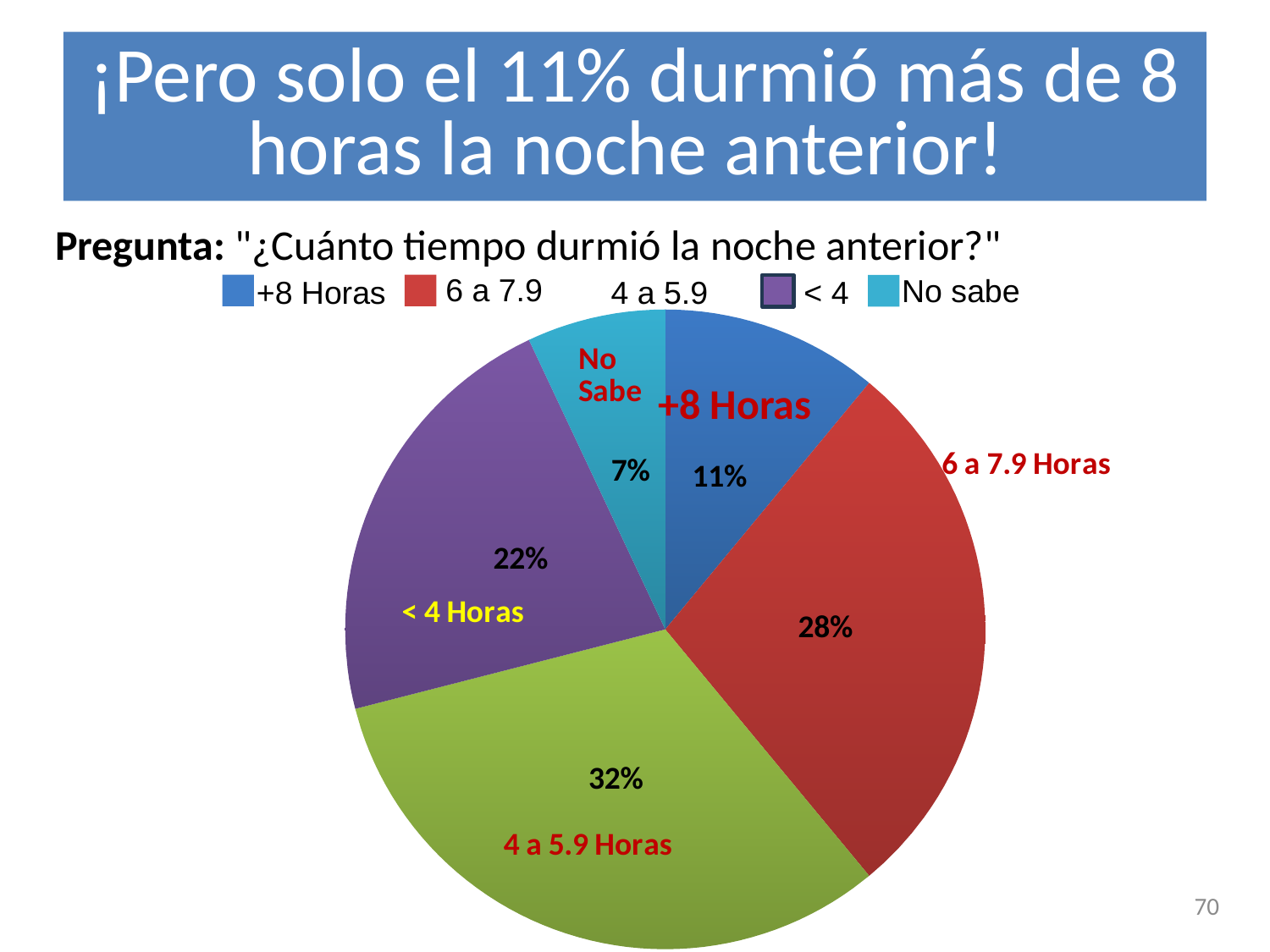
What is the difference in percentage points between the 4 a 5.9 Horas slice and the +8 Horas slice? 21 Which category has the largest share of the pie? 4 a 5.9 Horas What percentage of respondents slept +8 Horas? 11% Which is larger, the share for 6 a 7.9 Horas or the share for < 4 Horas? 6 a 7.9 Horas What colour is the slice for 4 a 5.9 Horas? green How many slices does the pie chart have? 5 What percentage of respondents answered No Sabe? 7% What percentage of respondents slept 4 a 5.9 Horas? 32% What percentage of respondents slept 6 a 7.9 Horas? 28% What percentage of respondents slept < 4 Horas? 22% What kind of chart is shown on the slide? pie chart Which category has the smallest share of the pie? No Sabe